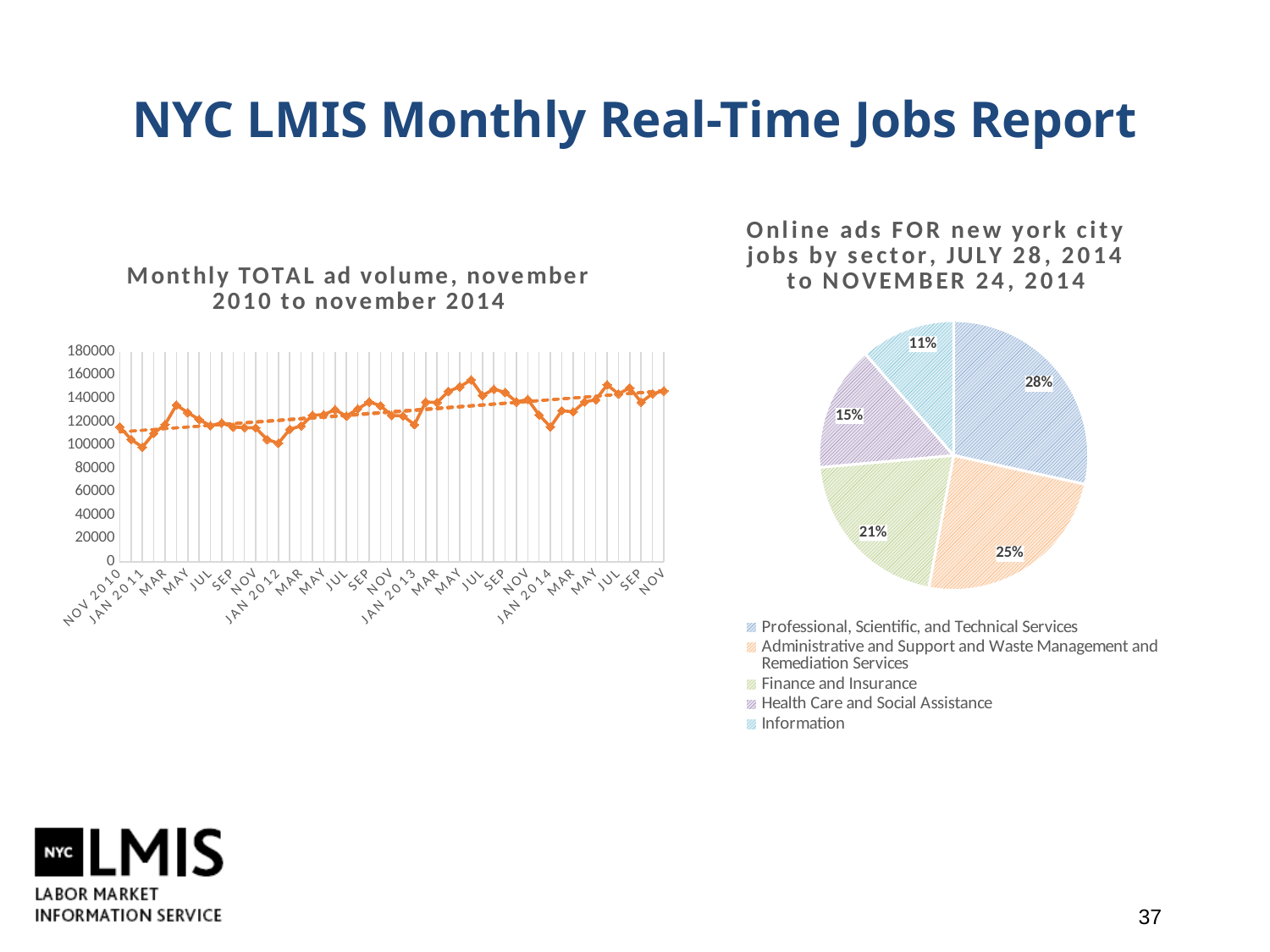
In the 'Monthly TOTAL ad volume' line chart, does the dashed trend line rise or fall from November 2010 to November 2014? rise What kind of chart is the 'Online ads FOR new york city jobs by sector' chart? pie chart In the 'Online ads FOR new york city jobs by sector' pie chart, which is larger: Finance and Insurance or Health Care and Social Assistance? Finance and Insurance In the 'Online ads FOR new york city jobs by sector' pie chart, what share is Finance and Insurance? 21% In the 'Online ads FOR new york city jobs by sector' pie chart, which sector has the largest share? Professional, Scientific, and Technical Services In the 'Online ads FOR new york city jobs by sector' pie chart, what share is Professional, Scientific, and Technical Services? 28% In the 'Online ads FOR new york city jobs by sector' pie chart, which sector has the smallest share? Information What kind of chart is the 'Monthly TOTAL ad volume, november 2010 to november 2014' chart? line chart In the 'Online ads FOR new york city jobs by sector' pie chart, what is the difference in percentage points between Administrative and Support and Waste Management and Remediation Services and Health Care and Social Assistance? 10 percentage points How many sectors does the legend of the 'Online ads FOR new york city jobs by sector' pie chart list? 5 In the 'Online ads FOR new york city jobs by sector' pie chart, what share is Information? 11%